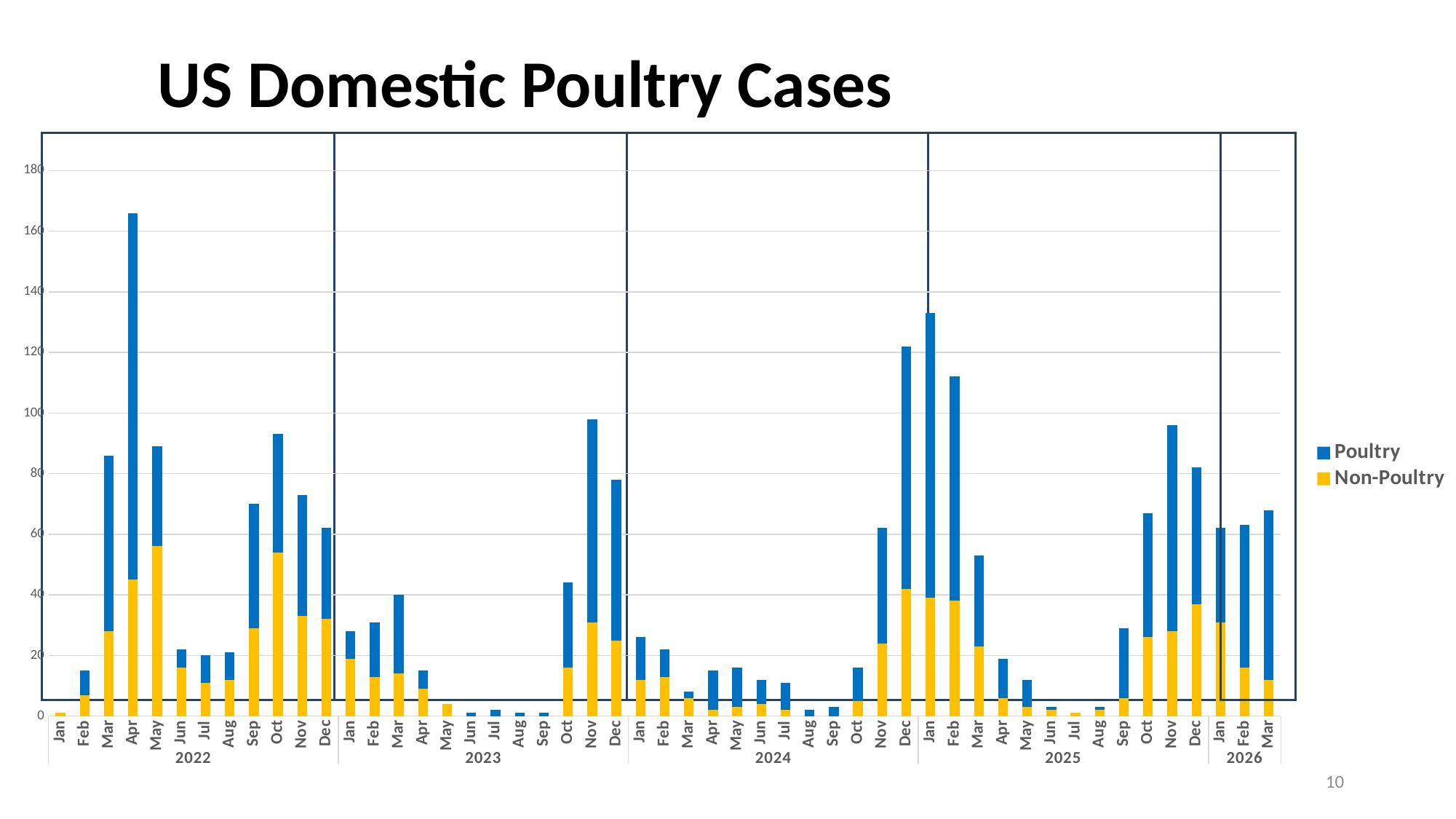
How many year groups are shown along the x axis? 5 Which month has the highest total number of cases across the whole chart? Apr 2022 Is the total value for Apr 2022 greater or less than 140? greater What is the title of the chart? US Domestic Poultry Cases Is the total value for Jan 2025 greater or less than 120? greater Which colour represents Non-Poultry in the chart? Yellow Which has a larger total, Jan 2025 or Dec 2024? Jan 2025 How many series does the legend list? 2 What kind of chart is shown on the slide? Stacked bar chart Is the total value for Nov 2025 greater or less than 100? less Do the total values rise or fall from Sep 2025 to Nov 2025? Rise